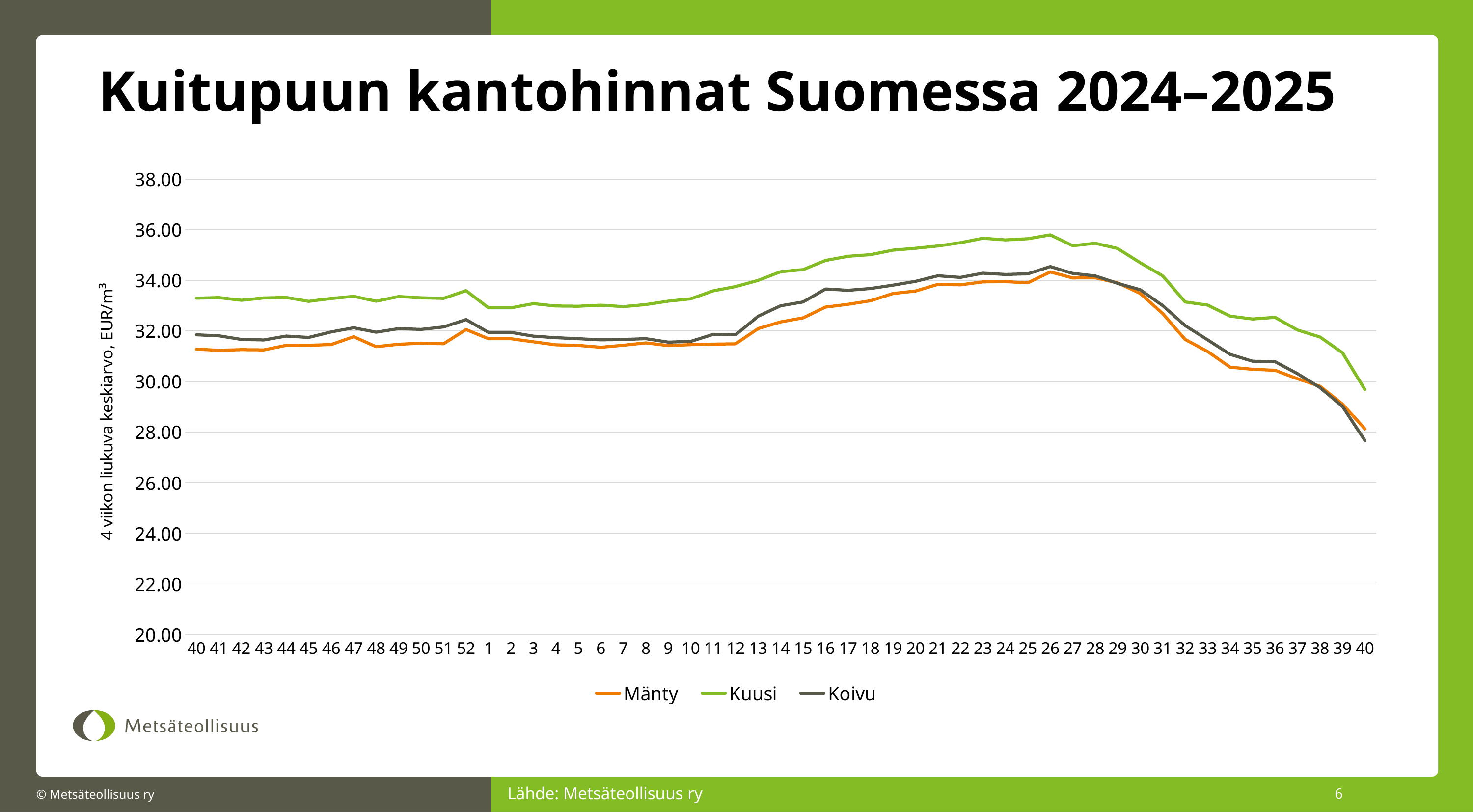
At week 26, which is larger, the value for Kuusi or the value for Mänty? Kuusi Which series has the lowest value at week 40 at the start of the x axis? Mänty What kind of chart is shown on the slide? Line chart Which series has the highest values across the whole chart? Kuusi At the final week 40, is the value for Koivu greater or less than 30.00? less At week 26, is the value for Kuusi greater or less than 34.00? greater Do the values for all three series rise or fall between week 26 and the final week 40? fall What is the title of the chart? Kuitupuun kantohinnat Suomessa 2024–2025 Which series are listed in the legend? Mänty, Kuusi, Koivu How many series does the legend list? 3 At the first week 40, is the value for Mänty greater or less than 30.00? greater How many week labels are shown on the x axis? 53